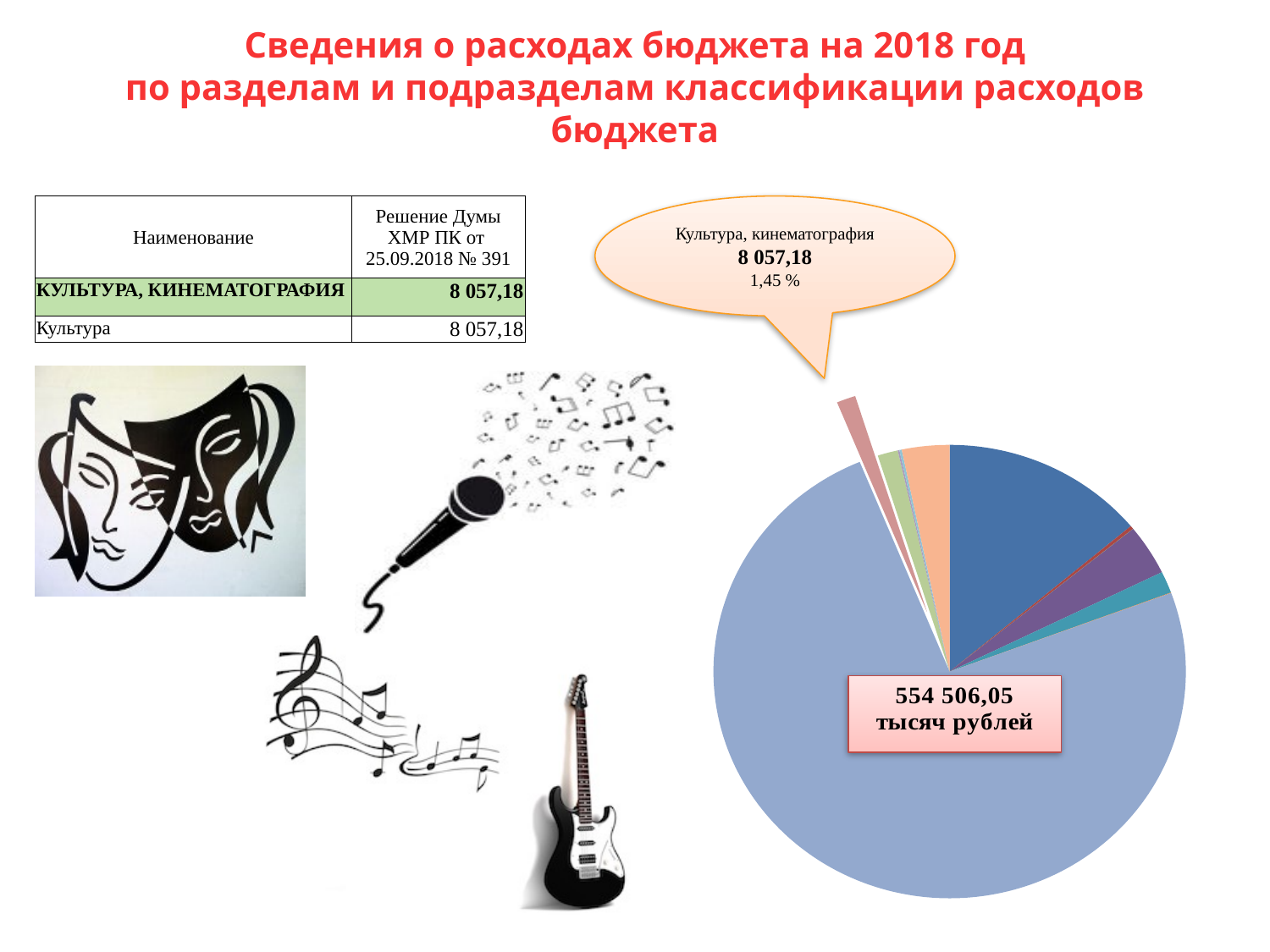
Is the Культура, кинематография slice pulled out (exploded) from the rest of the pie? yes What kind of chart is shown on the slide? pie chart What value does the callout on the pie chart give for Культура, кинематография? 8 057,18 Is the share of the Культура, кинематография slice greater or less than 10%? less What value does the table give for Культура? 8 057,18 Which category is labelled by the callout pointing to the pulled-out slice of the pie chart? Культура, кинематография What total amount is shown in the box on the pie chart? 554 506,05 тысяч рублей Is the Культура, кинематография slice larger or smaller than the large light-blue slice of the pie? smaller What value does the table give for КУЛЬТУРА, КИНЕМАТОГРАФИЯ under Решение Думы ХМР ПК от 25.09.2018 № 391? 8 057,18 What share of the pie does the Культура, кинематография slice represent, according to the callout? 1,45 %